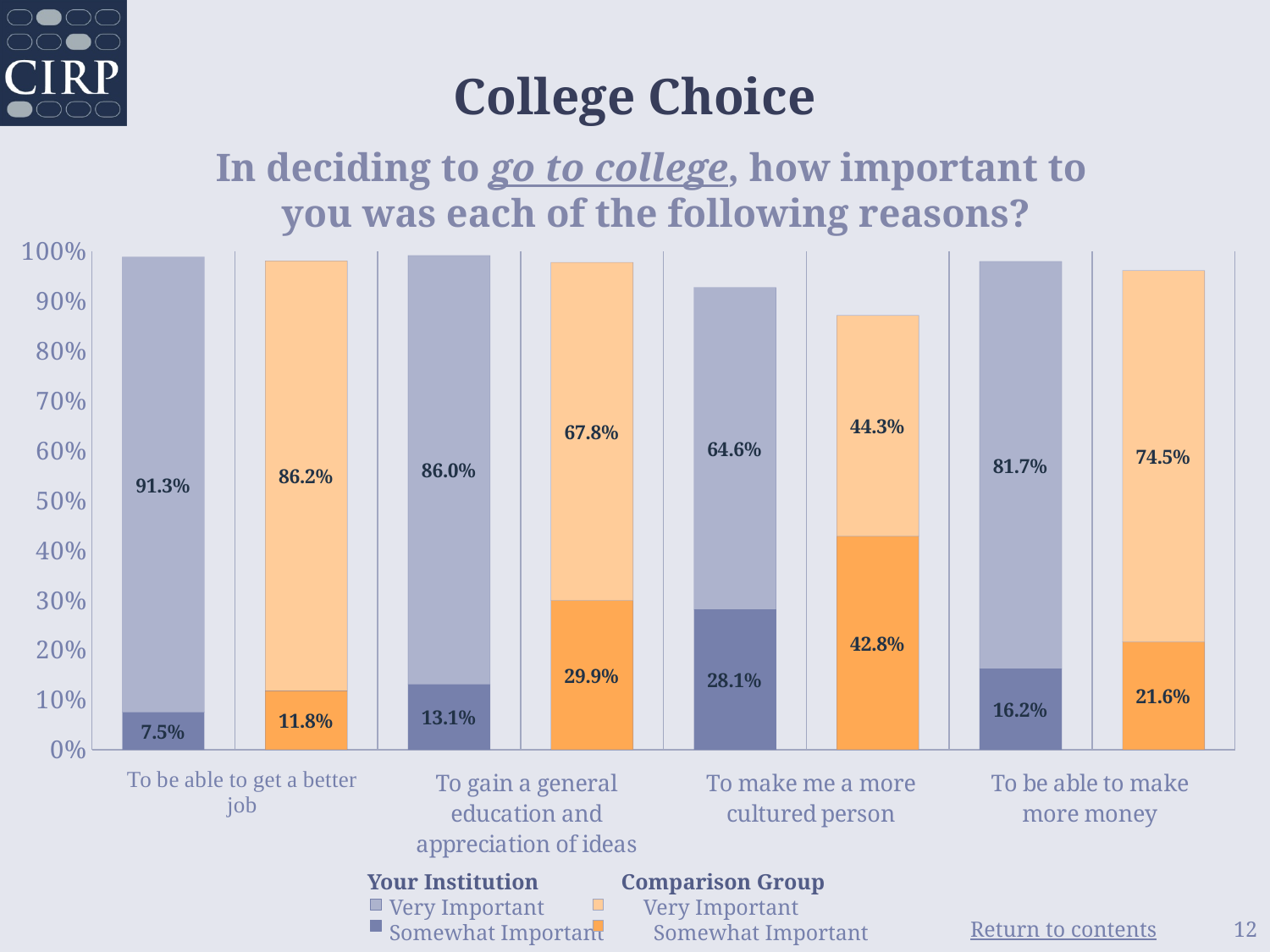
How many series does the legend list? 4 What percentage of Your Institution students rated "To be able to make more money" as Somewhat Important? 16.2% How many reasons (categories) are shown on the x axis? 4 What is the difference between the Your Institution and Comparison Group Very Important percentages for "To gain a general education and appreciation of ideas"? 18.2% What percentage of the Comparison Group rated "To make me a more cultured person" as Somewhat Important? 42.8% What is the total of the Comparison Group stacked bar for "To make me a more cultured person"? 87.1% What is the total of the Your Institution stacked bar for "To be able to get a better job"? 98.8% Which reason has the lowest Very Important percentage for the Comparison Group? To make me a more cultured person What kind of chart is shown on the slide? Stacked bar chart What percentage of Your Institution students rated "To be able to get a better job" as Very Important? 91.3% For "To be able to make more money", which is larger: the Very Important percentage for Your Institution or for the Comparison Group? Your Institution Which reason has the highest Very Important percentage for Your Institution? To be able to get a better job